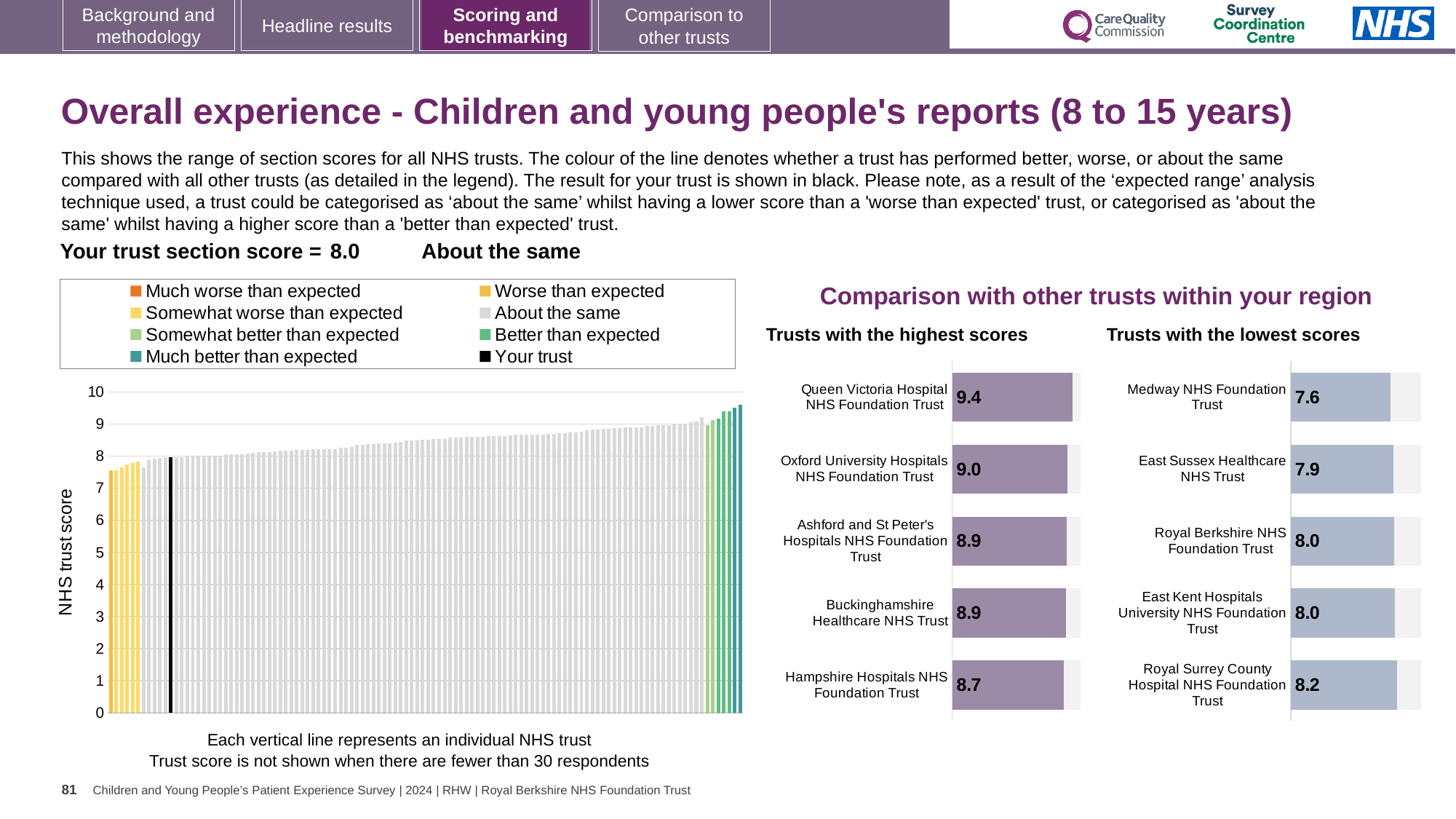
In the 'Trusts with the lowest scores' chart, what is the score for Medway NHS Foundation Trust? 7.6 How many trusts are shown in the 'Trusts with the highest scores' chart? 5 In the 'Trusts with the lowest scores' chart, what is the difference between the scores of Royal Surrey County Hospital NHS Foundation Trust and Medway NHS Foundation Trust? 0.6 In the 'Trusts with the highest scores' chart, which trust has the highest score? Queen Victoria Hospital NHS Foundation Trust In the 'Trusts with the highest scores' chart, what is the score for Queen Victoria Hospital NHS Foundation Trust? 9.4 Comparing the regional charts, which has the higher score: Oxford University Hospitals NHS Foundation Trust or Royal Surrey County Hospital NHS Foundation Trust? Oxford University Hospitals NHS Foundation Trust What kind of chart is the large 'NHS trust score' chart on the left of the slide? Bar chart In the 'Trusts with the highest scores' chart, what is the difference between the scores of Queen Victoria Hospital NHS Foundation Trust and Hampshire Hospitals NHS Foundation Trust? 0.7 How many entries does the legend above the 'NHS trust score' chart list? 8 In the 'Trusts with the lowest scores' chart, which trust has the lowest score? Medway NHS Foundation Trust According to the slide, what is your trust's section score shown in the 'NHS trust score' chart? 8.0 In the 'NHS trust score' chart on the left, do the bar values rise or fall from left to right? Rise